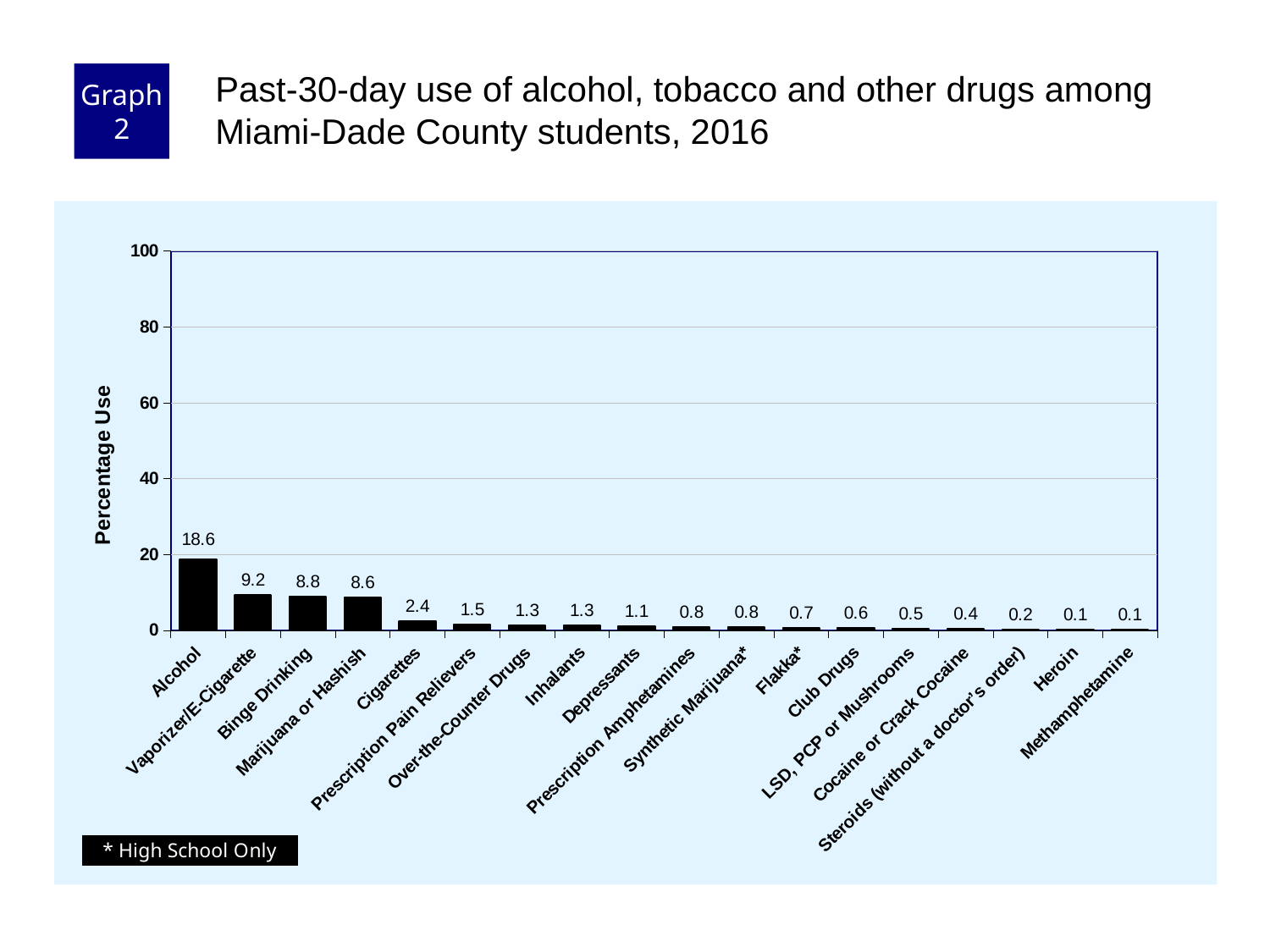
Which has a higher percentage use, Binge Drinking or Marijuana or Hashish? Binge Drinking Which category has the highest percentage use? Alcohol What is the percentage use for Cigarettes? 2.4 What kind of chart is shown on the slide? Bar chart How many categories are shown on the x axis? 18 What is the percentage use for Cocaine or Crack Cocaine? 0.4 What is the difference in percentage use between Alcohol and Vaporizer/E-Cigarette? 9.4 What is the difference in percentage use between Binge Drinking and Cigarettes? 6.4 What is the percentage use for Alcohol? 18.6 What is the percentage use for Marijuana or Hashish? 8.6 What is the percentage use for Vaporizer/E-Cigarette? 9.2 Is the value for Alcohol greater or less than 20? less